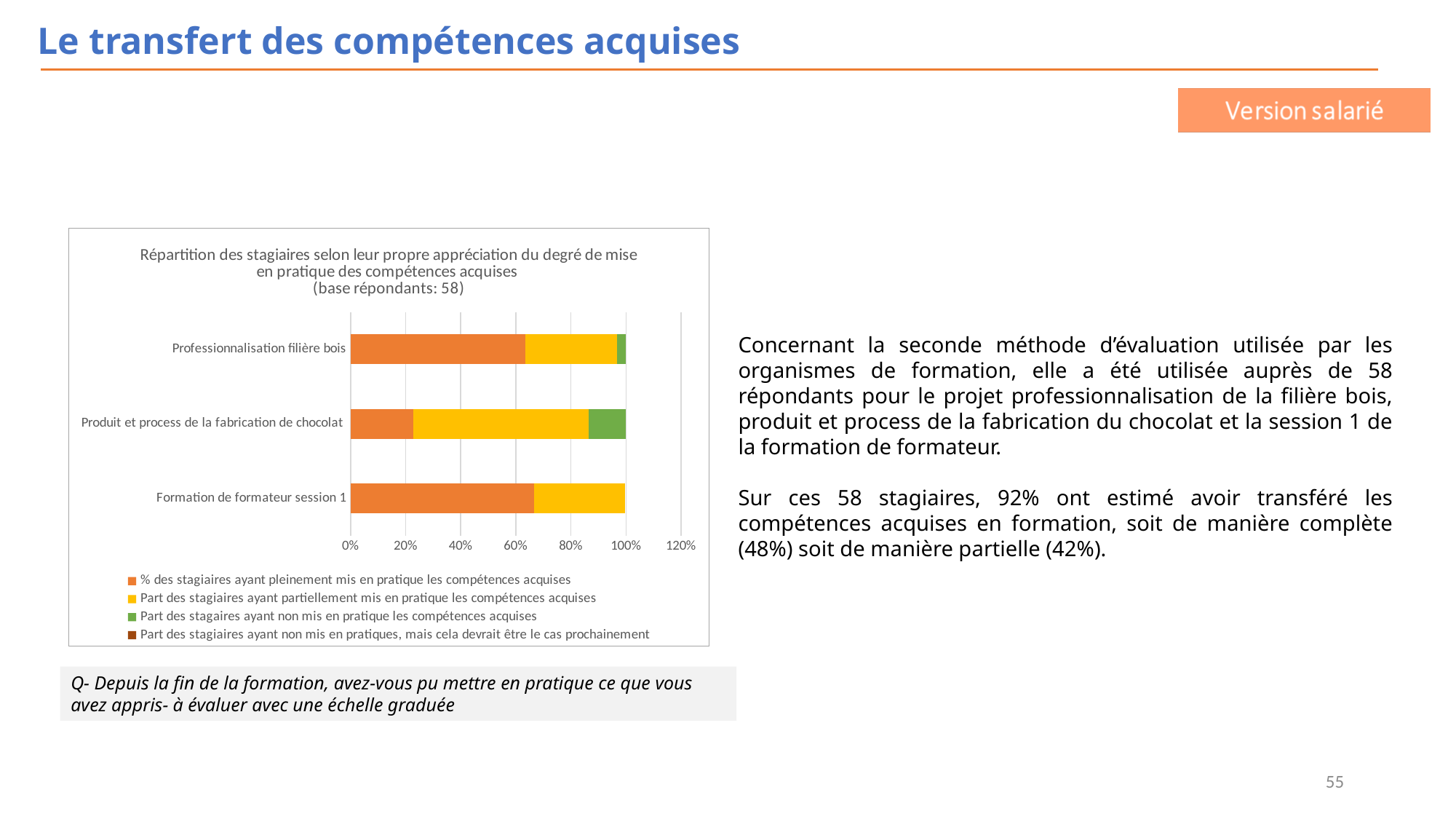
Which colour represents '% des stagiaires ayant pleinement mis en pratique les compétences acquises'? Orange Which has the larger share of trainees who fully put skills into practice: 'Produit et process de la fabrication de chocolat' or 'Formation de formateur session 1'? Formation de formateur session 1 What is the respondent base stated in the chart title? 58 Is the share of trainees who fully put skills into practice for 'Produit et process de la fabrication de chocolat' greater or less than 40%? less Which programme has the largest share of trainees who did not put skills into practice (green segment)? Produit et process de la fabrication de chocolat Is the share of trainees who did not put skills into practice for 'Produit et process de la fabrication de chocolat' greater or less than 20%? less Is the share of trainees who fully put skills into practice for 'Professionnalisation filière bois' greater or less than 40%? greater How many training programmes (categories) are plotted on the chart? 3 What kind of chart is shown on the slide? Stacked bar chart Which programme has the smallest share of trainees who fully put skills into practice? Produit et process de la fabrication de chocolat How many series does the chart legend list? 4